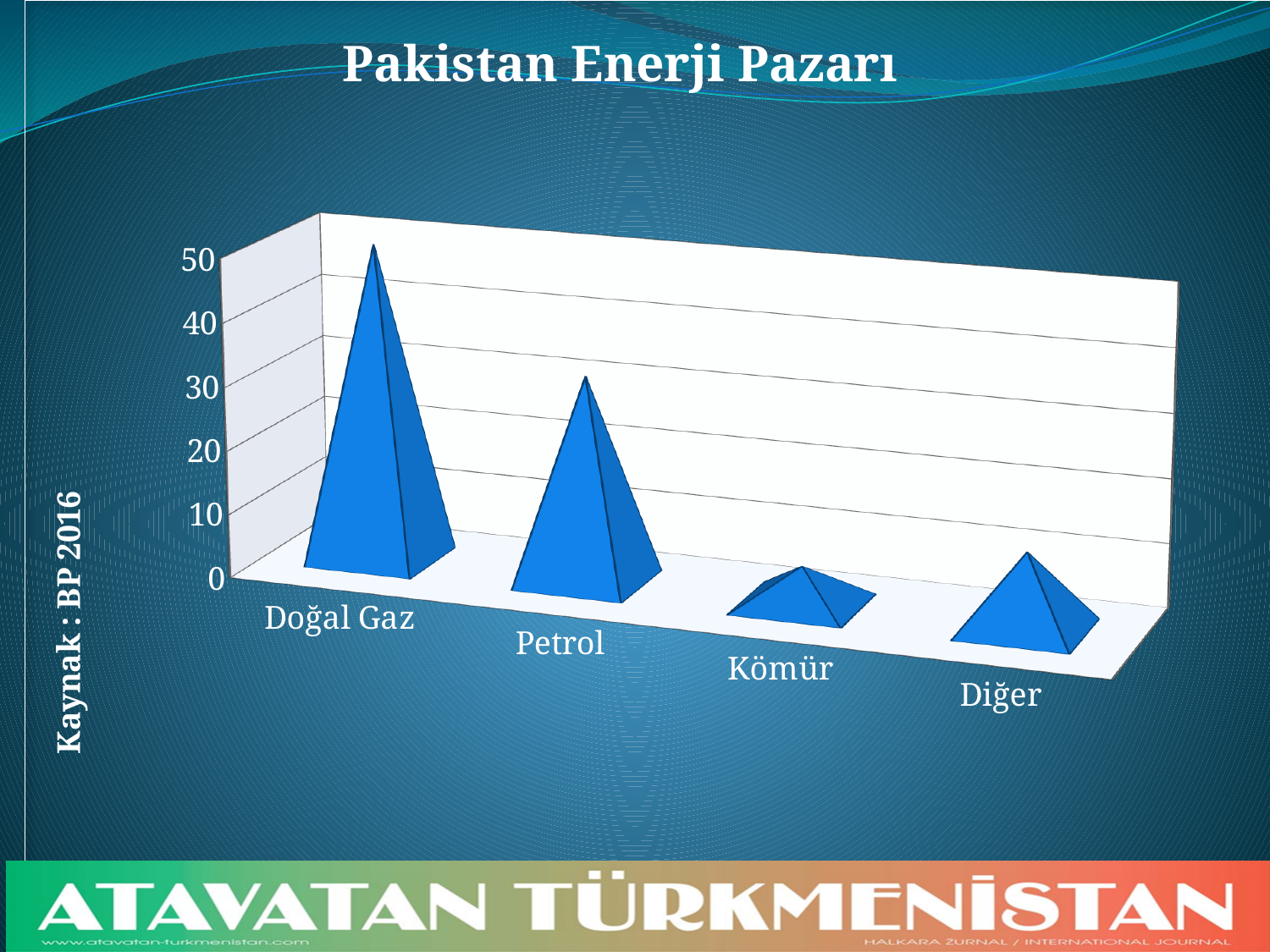
What kind of chart is shown on the slide? bar chart Which category has the highest value in the chart? Doğal Gaz Is the value for Diğer greater or less than 20? less What is the title of the chart? Pakistan Enerji Pazarı Which category has the lowest value in the chart? Kömür Is the value for Doğal Gaz greater or less than 30? greater Is the value for Kömür greater or less than 10? less How many categories are shown on the x axis of the chart? 4 What source is cited for the chart data? BP 2016 Which is larger, the value for Petrol or the value for Kömür? Petrol Which is larger, the value for Doğal Gaz or the value for Petrol? Doğal Gaz